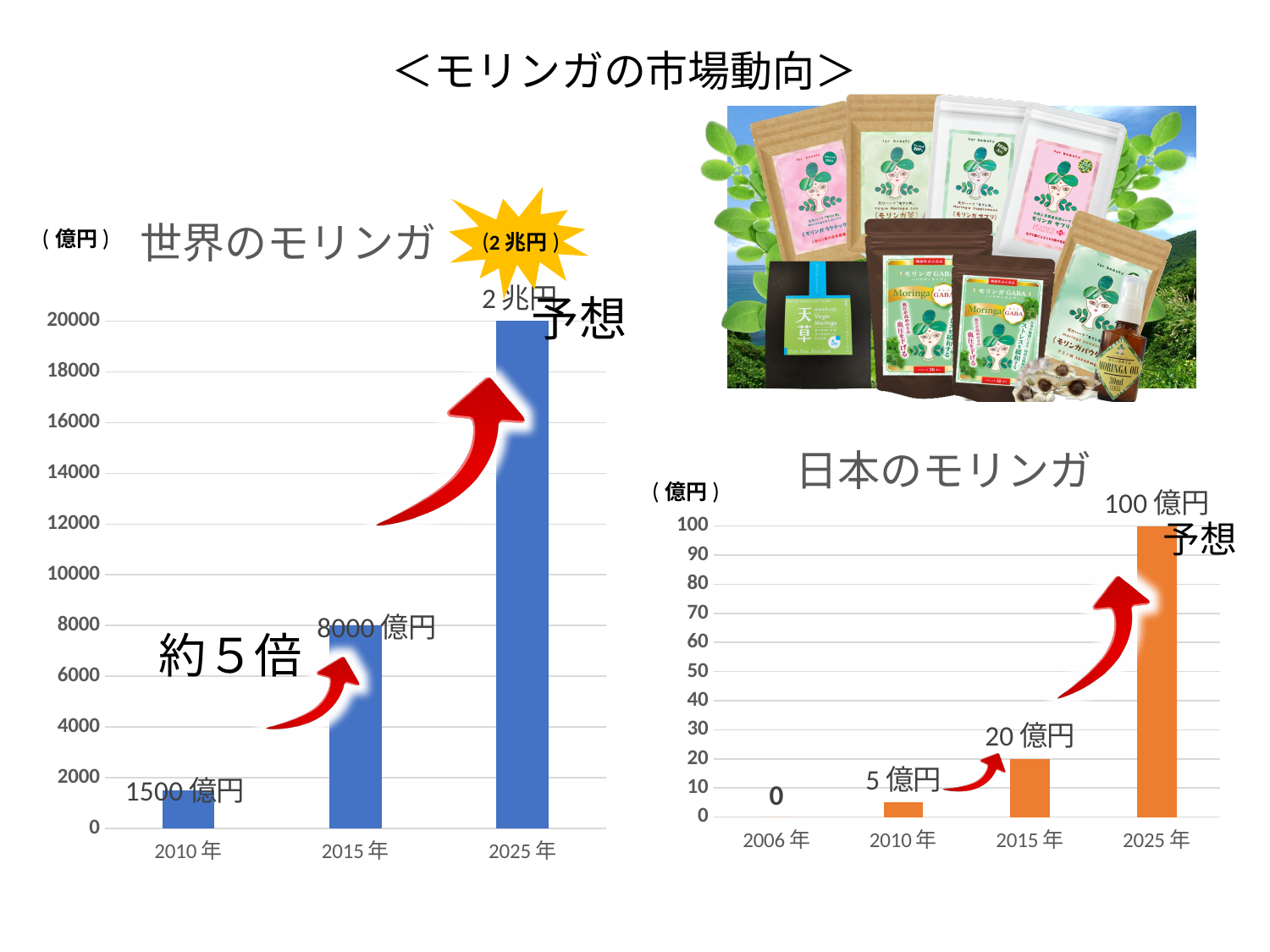
In the 日本のモリンガ chart, what is the value for 2025年? 100億円 What type of chart is the 日本のモリンガ chart? Bar chart In the 世界のモリンガ chart, what is the value labelled for 2025年? 2兆円 In the 世界のモリンガ chart, which year has the highest value? 2025年 In the 日本のモリンガ chart, what is the difference between the 2025年 and 2015年 values? 80億円 In the 日本のモリンガ chart, what is the value for 2010年? 5億円 In the 世界のモリンガ chart, what is the value for 2015年? 8000億円 In the 世界のモリンガ chart, what is the value for 2010年? 1500億円 In the 日本のモリンガ chart, how many years are shown on the x axis? 4 In the 世界のモリンガ chart, what is the difference between the 2015年 and 2010年 values? 6500億円 In the 日本のモリンガ chart, what is the value for 2015年? 20億円 In the 日本のモリンガ chart, which year has the lowest value? 2006年